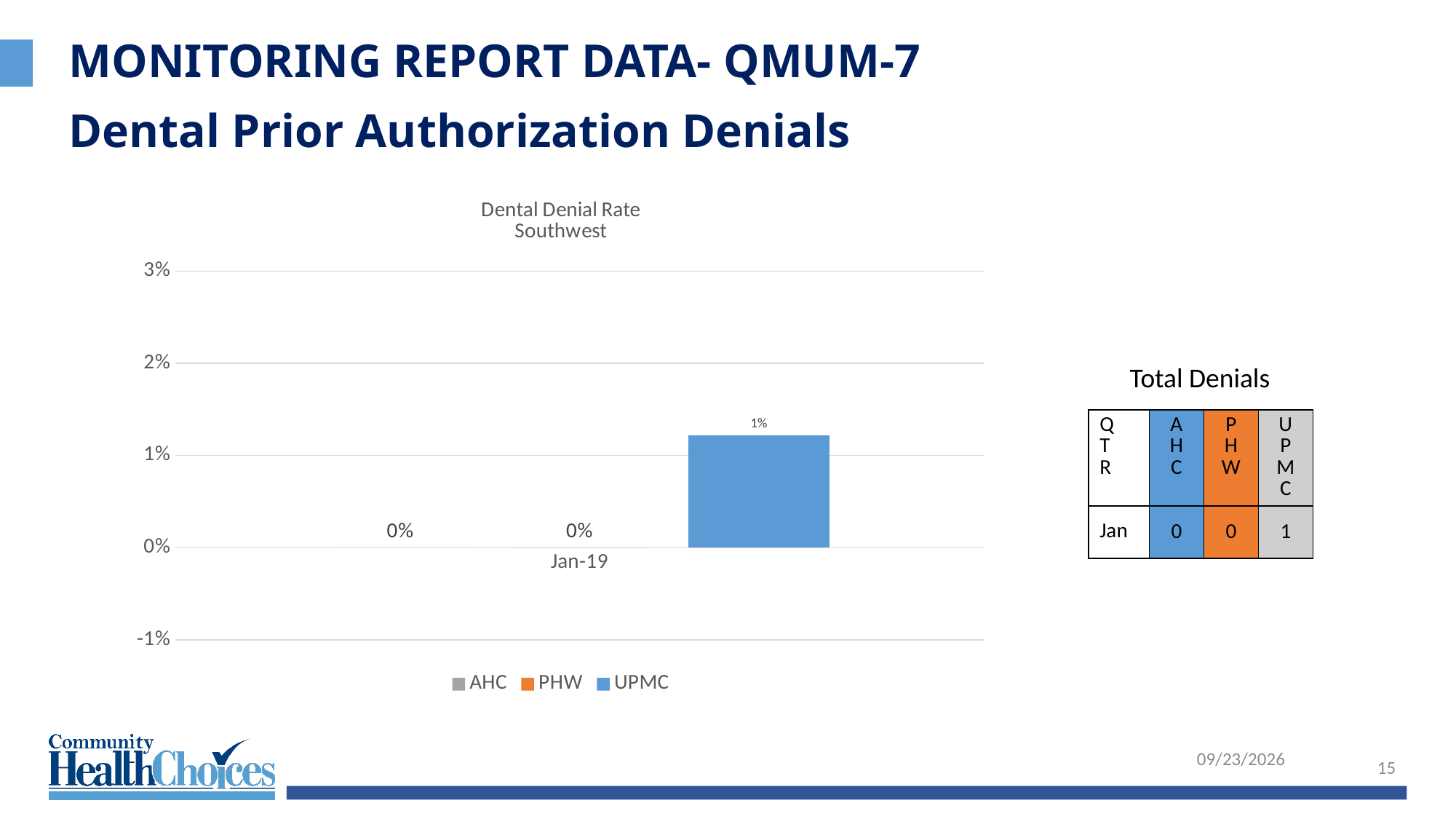
Is the UPMC denial rate for Jan-19 greater or less than 2%? less Which series has the highest Dental Denial Rate in Jan-19? UPMC How many time periods are shown on the x axis of the chart? 1 What is the title of the chart? Dental Denial Rate Southwest What is the Dental Denial Rate for PHW in Jan-19? 0% What is the Dental Denial Rate for AHC in Jan-19? 0% What colour represents UPMC in the chart legend? blue How many series does the chart legend list? 3 What kind of chart is shown on the slide? bar chart What is the Dental Denial Rate for UPMC in Jan-19? 1% What is the difference between the UPMC and PHW denial rates in Jan-19? 1% Which is larger in Jan-19, the denial rate for UPMC or for AHC? UPMC